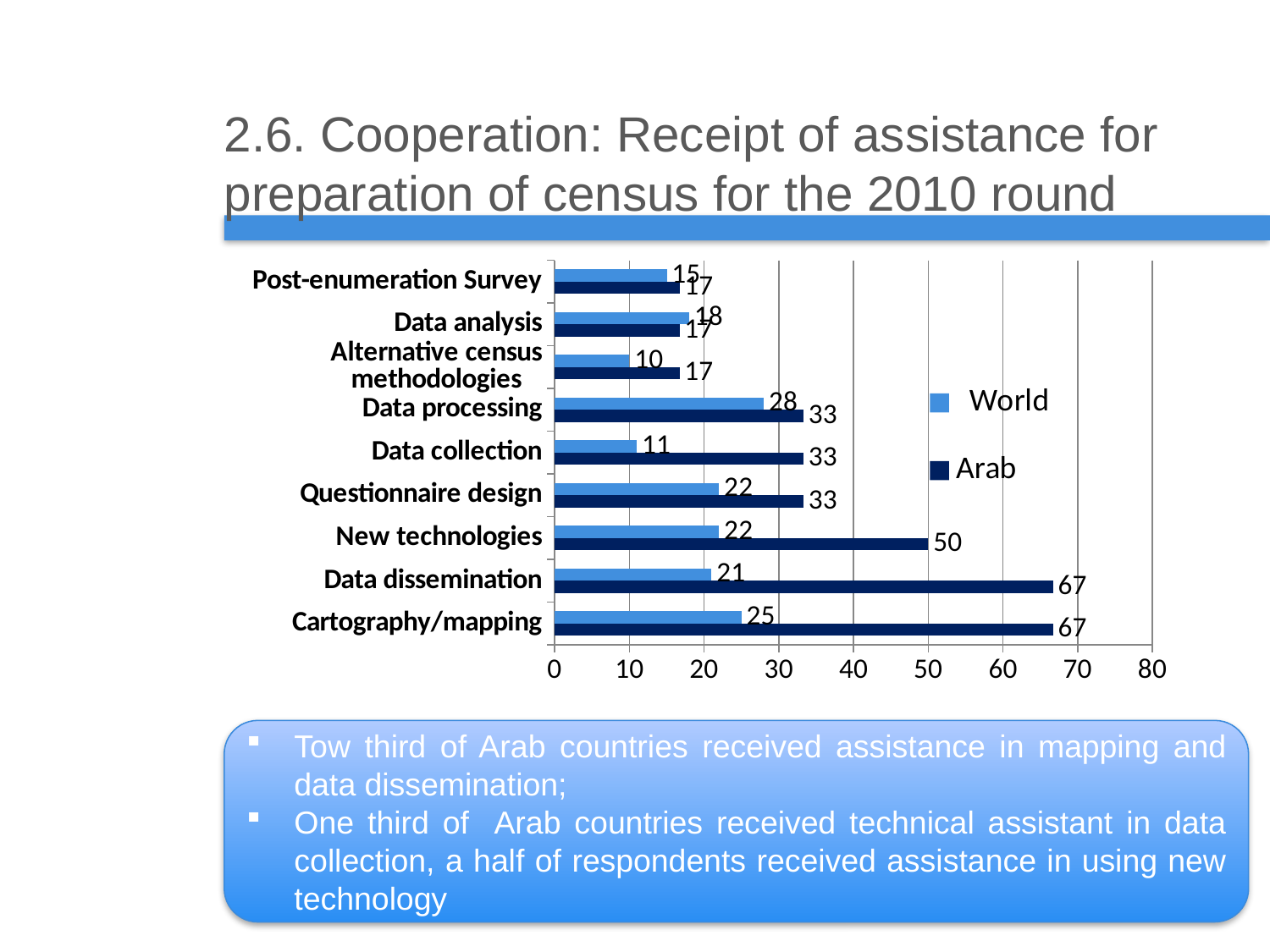
Which series is shown in dark blue in the legend? Arab Which is larger for Data analysis, the World value or the Arab value? World Which category has the lowest World value? Alternative census methodologies What is the Arab value for Data dissemination? 67 How many categories are shown on the chart? 9 What is the World value for Data collection? 11 What is the World value for Cartography/mapping? 25 What is the difference between the Arab and World values for Data collection? 22 What kind of chart is shown on the slide? Bar chart How many series does the legend list? 2 What is the Arab value for New technologies? 50 Which category has the highest World value? Data processing